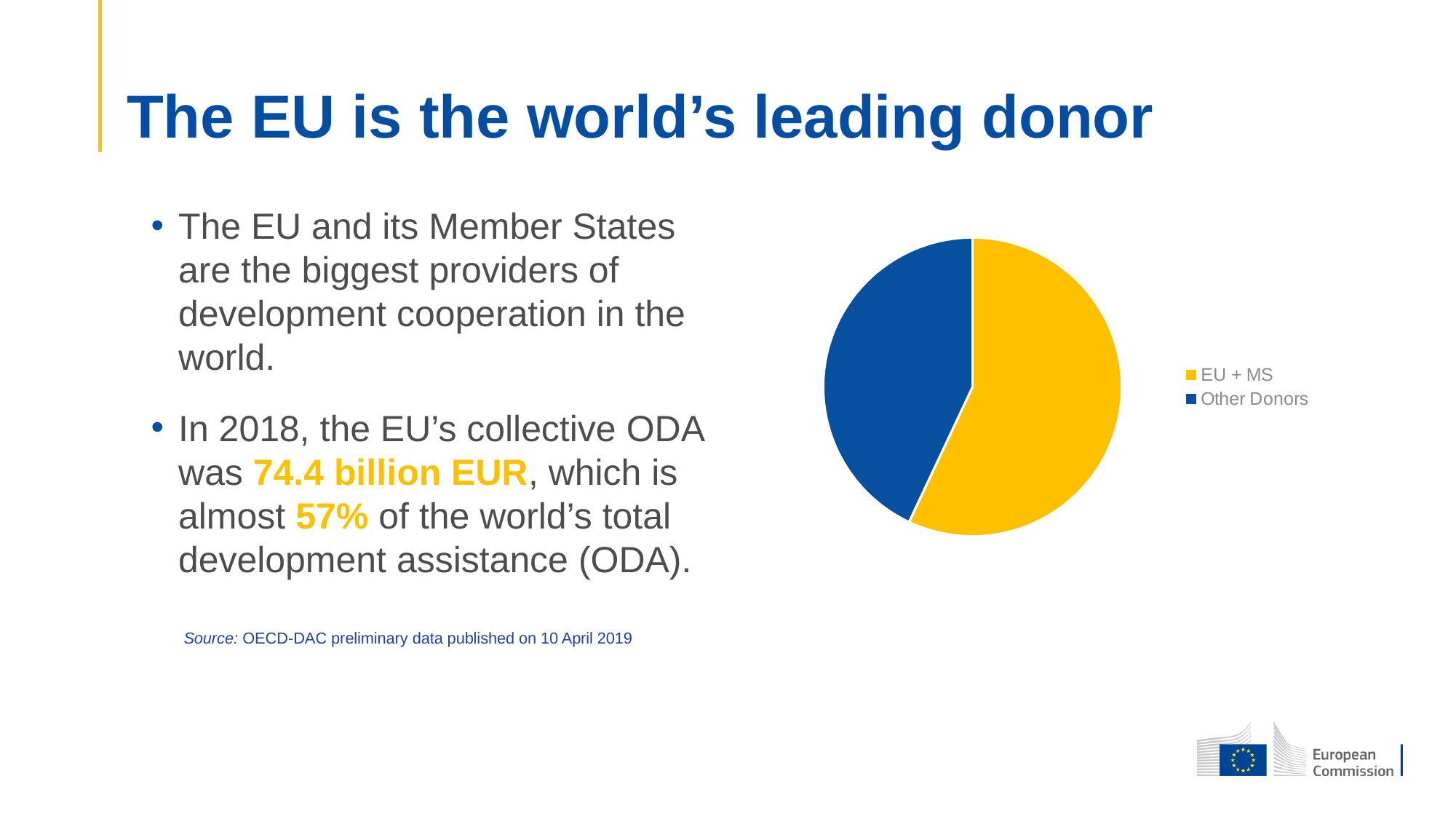
What kind of chart is shown on the slide? pie chart In the pie chart, which is larger: EU + MS or Other Donors? EU + MS How many entries does the legend of the pie chart list? 2 Which slice of the pie chart is the smallest? Other Donors Which legend entry is shown in blue in the pie chart? Other Donors How many slices does the pie chart have? 2 What colour is the EU + MS slice in the pie chart? yellow Which slice of the pie chart is the largest? EU + MS